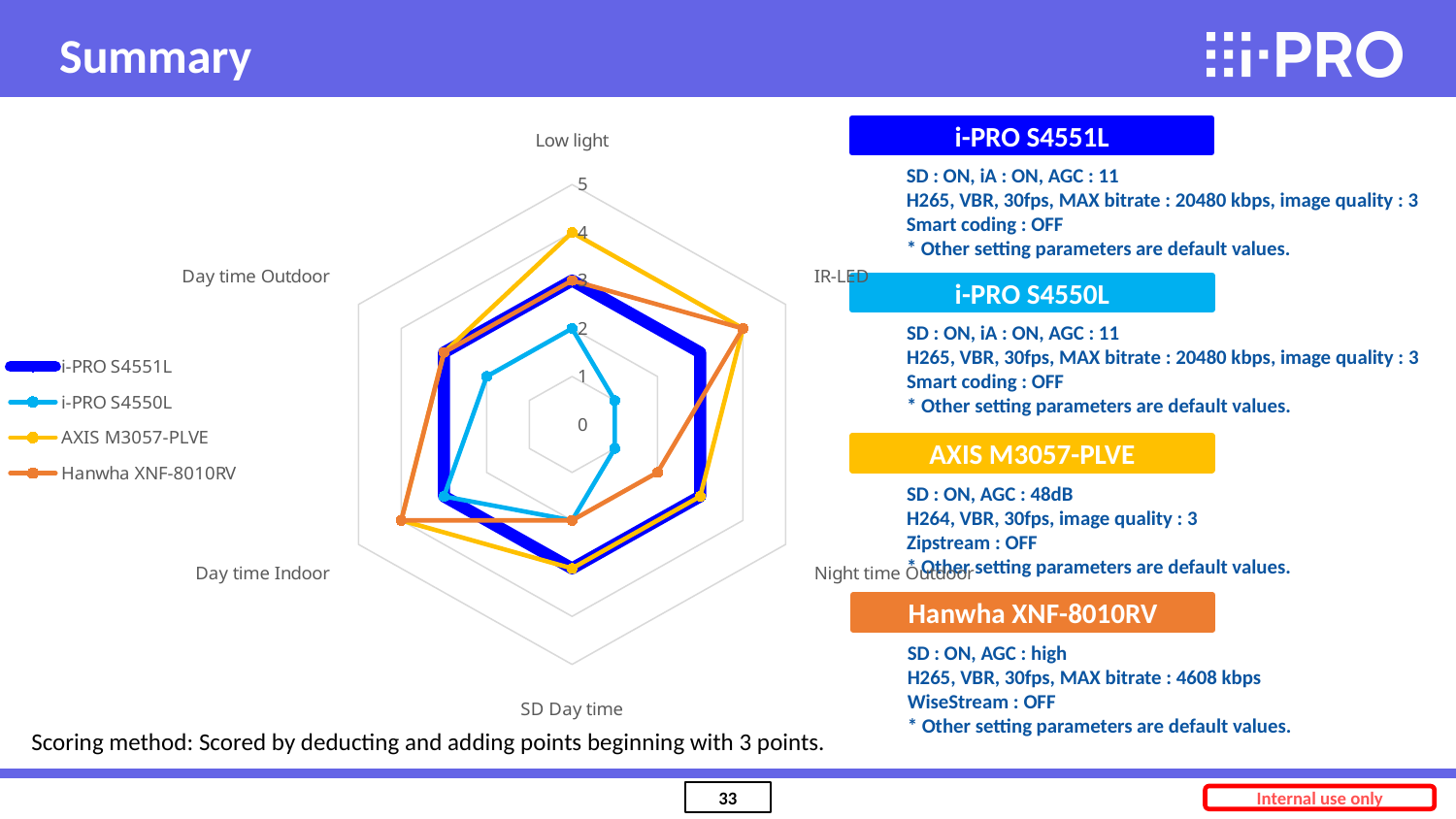
What score does AXIS M3057-PLVE get on the Low light axis? 4 Which series scores lowest on the Low light axis? i-PRO S4550L How many series does the chart legend list? 4 What kind of chart is shown on the slide? Radar chart What is the difference between the Low light scores of AXIS M3057-PLVE and i-PRO S4550L? 2 On the IR-LED axis, which scores higher: i-PRO S4551L or i-PRO S4550L? i-PRO S4551L Which series is drawn with the thick dark blue line in the chart? i-PRO S4551L What is the maximum value shown on the radar chart's scale? 5 What score does i-PRO S4550L get on the Low light axis? 2 How many axes (categories) does the radar chart have? 6 Which series scores highest on the Low light axis? AXIS M3057-PLVE Is the value for i-PRO S4550L on the IR-LED axis greater or less than 2? less